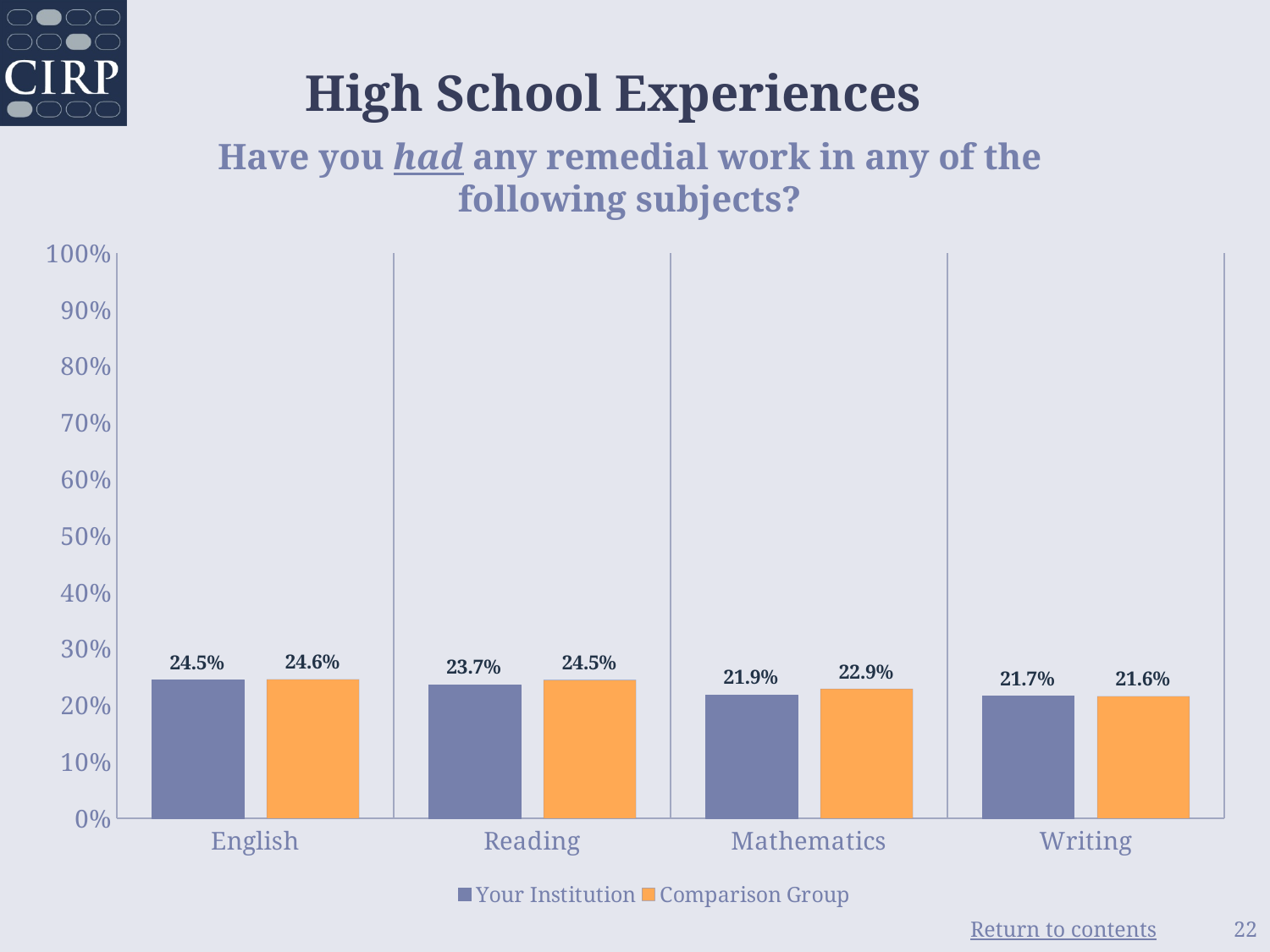
What is the value for Your Institution in Writing? 21.7% Which subject has the lowest value for Comparison Group? Writing Which is larger for Reading: Your Institution or Comparison Group? Comparison Group What is the value for Comparison Group in Reading? 24.5% How many series does the legend list? 2 What kind of chart is shown on the slide? bar chart What is the difference between the Comparison Group and Your Institution values for Mathematics? 1.0% Is the value for Your Institution in English greater or less than 30%? less Which subject has the highest value for Your Institution? English What is the value for Comparison Group in Mathematics? 22.9% How many subjects are shown on the x axis? 4 What is the value for Your Institution in English? 24.5%